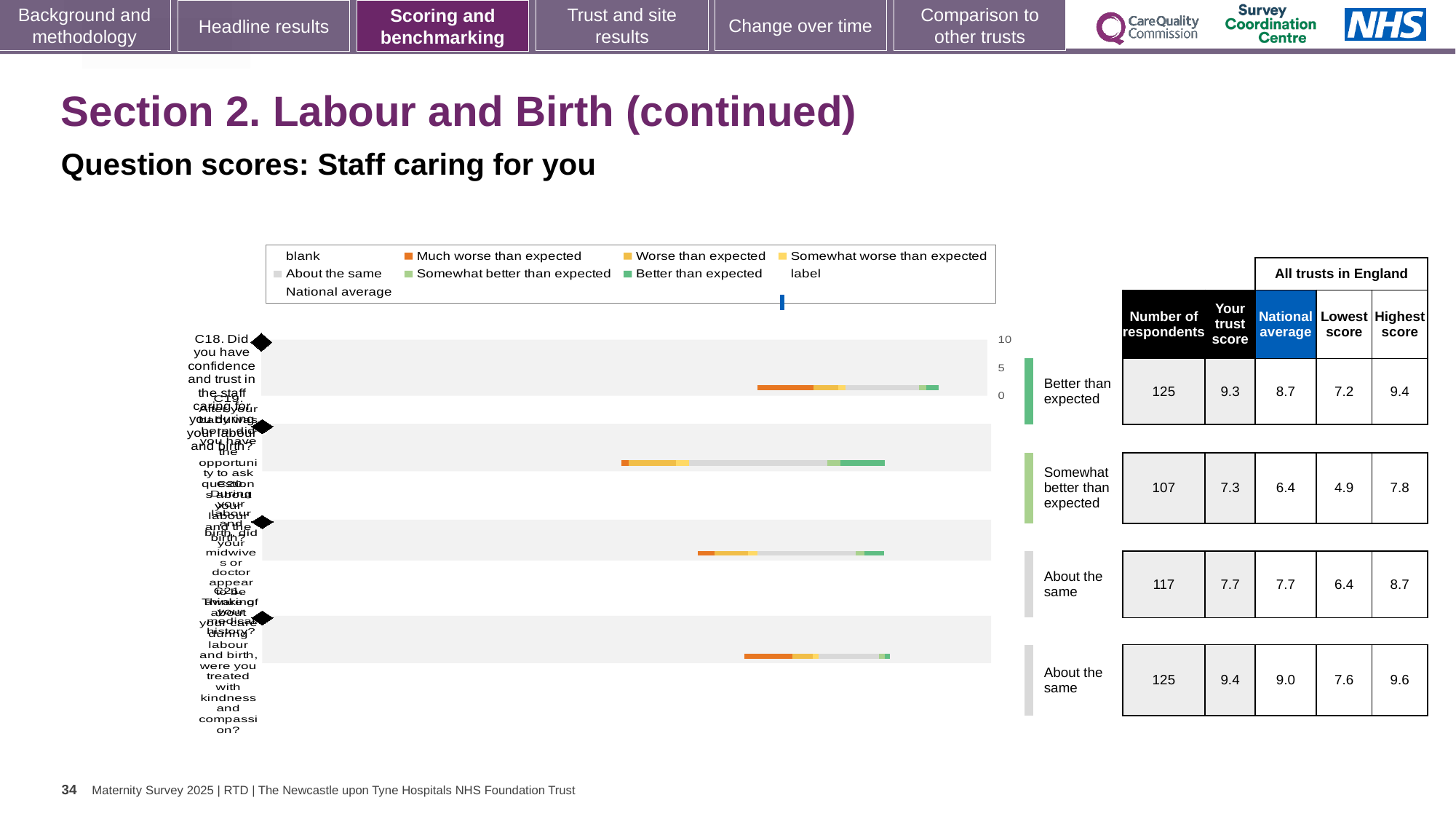
Which row of the table has the highest 'Your trust score'? the fourth (bottom) row, 9.4 Which row of the table has the lowest 'Your trust score'? the second row (Somewhat better than expected), 7.3 How many question bars are plotted in the chart? 4 In the chart legend, what colour represents 'Much worse than expected'? orange What is the difference between 'Your trust score' and the national average in the row rated 'Better than expected'? 0.6 In the table, what is the national average for the row rated 'Somewhat better than expected'? 6.4 In the table, what is 'Your trust score' for the row rated 'Better than expected'? 9.3 What kind of chart is shown on the slide? bar chart In the table, what is the number of respondents for the row rated 'Better than expected'? 125 In the table, what is the highest score in the fourth (bottom) row? 9.6 In the table, what is the lowest score for the row rated 'Somewhat better than expected'? 4.9 In the table, what is the number of respondents in the third row? 117